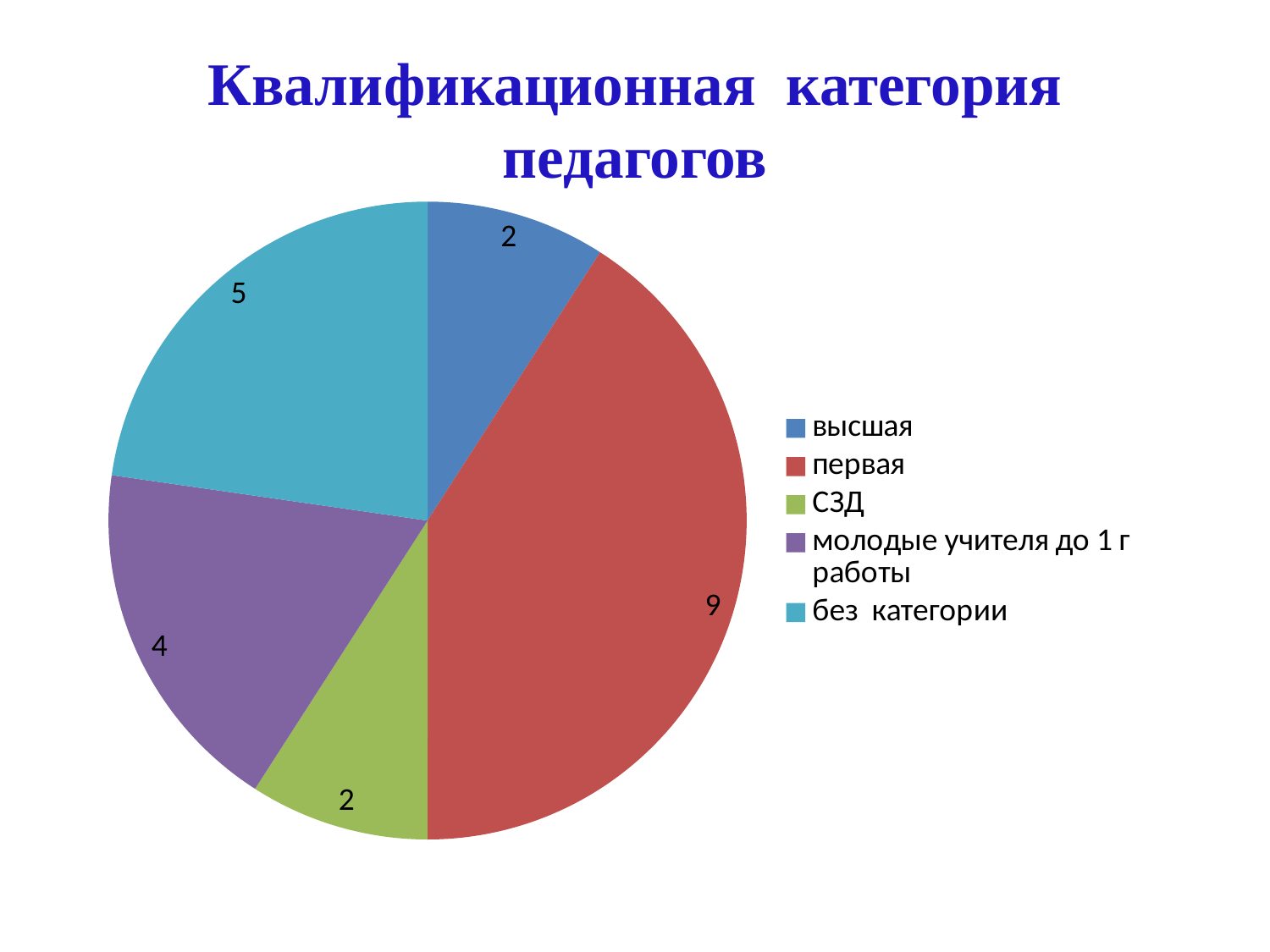
What is the difference between the values for 'первая' and 'без категории'? 4 Which category has the smallest value, 'СЗД' or 'без категории'? СЗД How many slices does the pie chart have? 5 What is the value for the 'молодые учителя до 1 г работы' slice? 4 What is the title of the slide? Квалификационная категория педагогов What kind of chart is shown on the slide? pie chart How many entries does the legend list? 5 What is the value for the 'первая' slice? 9 Which is larger, the value for 'молодые учителя до 1 г работы' or the value for 'СЗД'? молодые учителя до 1 г работы What is the value for the 'высшая' slice? 2 Which category has the largest slice of the pie? первая What is the value for the 'без категории' slice? 5